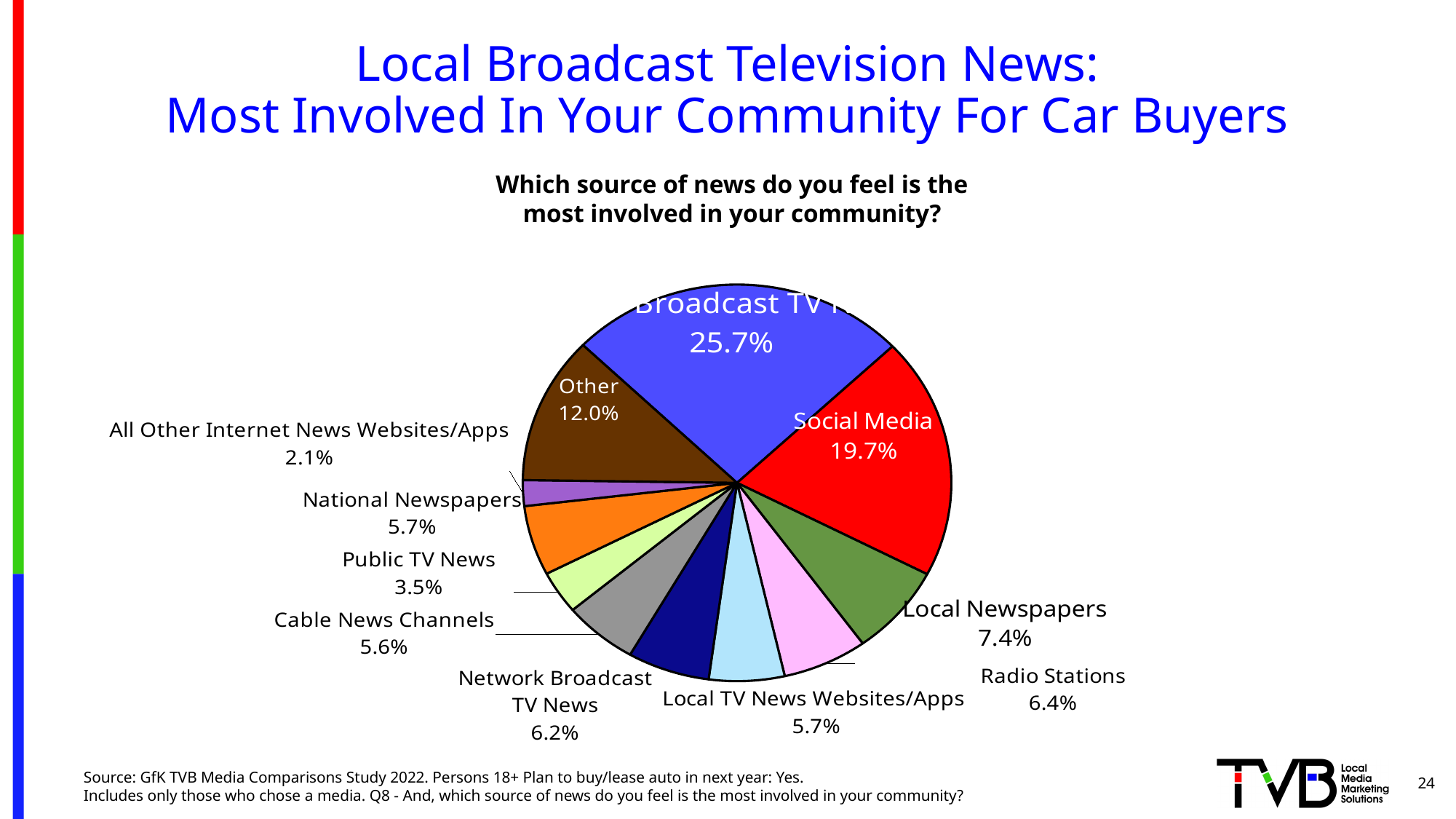
Which has a larger share: Network Broadcast TV News or Cable News Channels? Network Broadcast TV News How many percentage points larger is Social Media than Local Newspapers? 12.3 percentage points What percentage is shown for Local Newspapers in the pie chart? 7.4% What value is shown for Radio Stations? 6.4% What is the difference between Radio Stations and Local TV News Websites/Apps? 0.7 percentage points How many slices does the pie chart have? 11 What share of respondents chose Social Media as the news source most involved in their community? 19.7% Which news source has the smallest slice in the pie chart? All Other Internet News Websites/Apps What type of chart is shown on the slide? Pie chart What value is shown for Public TV News? 3.5% What percentage does the Other slice represent? 12.0% Which is larger: Other or Local Newspapers? Other